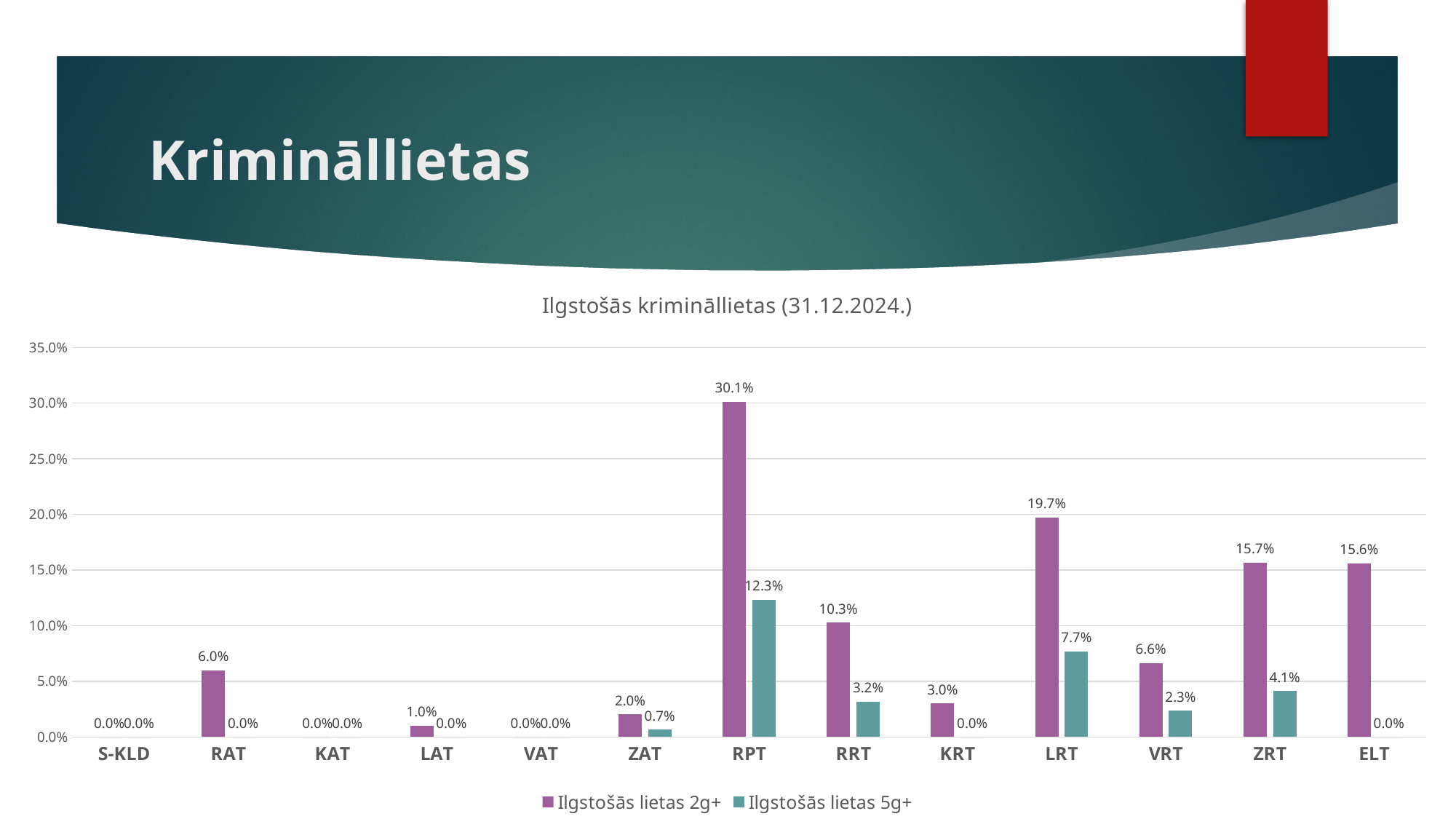
What is the value of Ilgstošās lietas 5g+ for LRT? 7.7% What is the title of the chart? Ilgstošās krimināllietas (31.12.2024.) What is the difference between the Ilgstošās lietas 2g+ and Ilgstošās lietas 5g+ values for RRT? 7.1% What is the value of Ilgstošās lietas 2g+ for ZRT? 15.7% Which is larger: the Ilgstošās lietas 2g+ value for LRT or for ZRT? LRT What kind of chart is shown on the slide? bar chart Which category has the highest value for Ilgstošās lietas 2g+? RPT Is the Ilgstošās lietas 2g+ value for VRT greater or less than 10.0%? less How many series does the legend list? 2 How many categories are shown on the x axis? 13 What is the value of Ilgstošās lietas 2g+ for RPT? 30.1% Which category has the highest value for Ilgstošās lietas 5g+? RPT